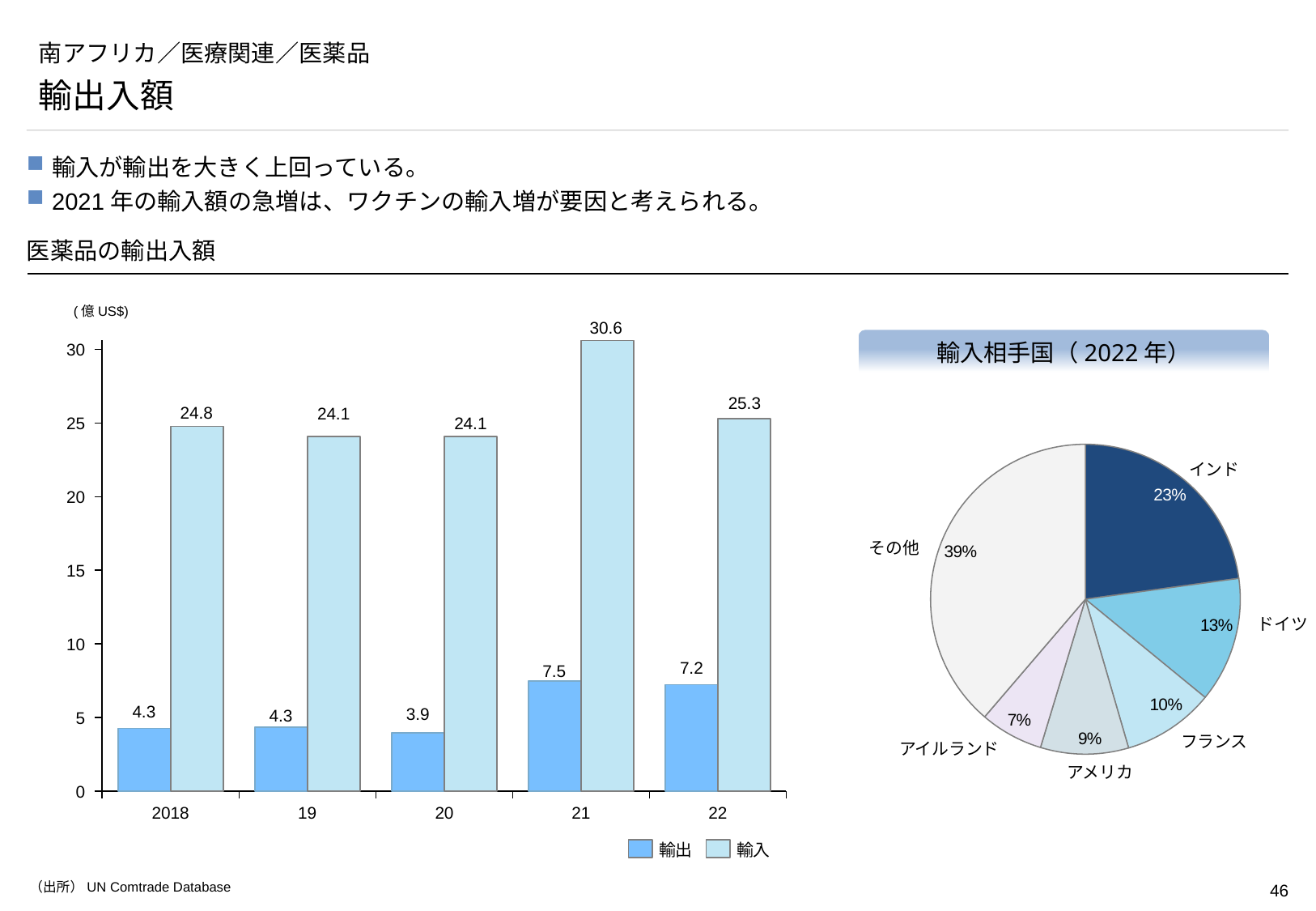
In the bar chart 医薬品の輸出入額, what is the difference between 輸入 and 輸出 in 22? 18.1 In the bar chart 医薬品の輸出入額, what is the value of 輸出 for 21? 7.5 In the bar chart 医薬品の輸出入額, which year has the highest 輸入 value? 21 In the bar chart 医薬品の輸出入額, what is the value of 輸入 for 2018? 24.8 In the bar chart 医薬品の輸出入額, how many series does the legend list? 2 In the pie chart 輸入相手国（2022年）, which of ドイツ and フランス has the larger share? ドイツ In the pie chart 輸入相手国（2022年）, what is the difference between the shares of アメリカ and アイルランド? 2% In the bar chart 医薬品の輸出入額, which year has the lowest 輸出 value? 20 In the pie chart 輸入相手国（2022年）, what share does インド have? 23% In the bar chart 医薬品の輸出入額, how many years are shown on the x axis? 5 In the bar chart 医薬品の輸出入額, is the 輸入 value for 21 greater or less than 30? greater What kind of chart is 輸入相手国（2022年）? pie chart